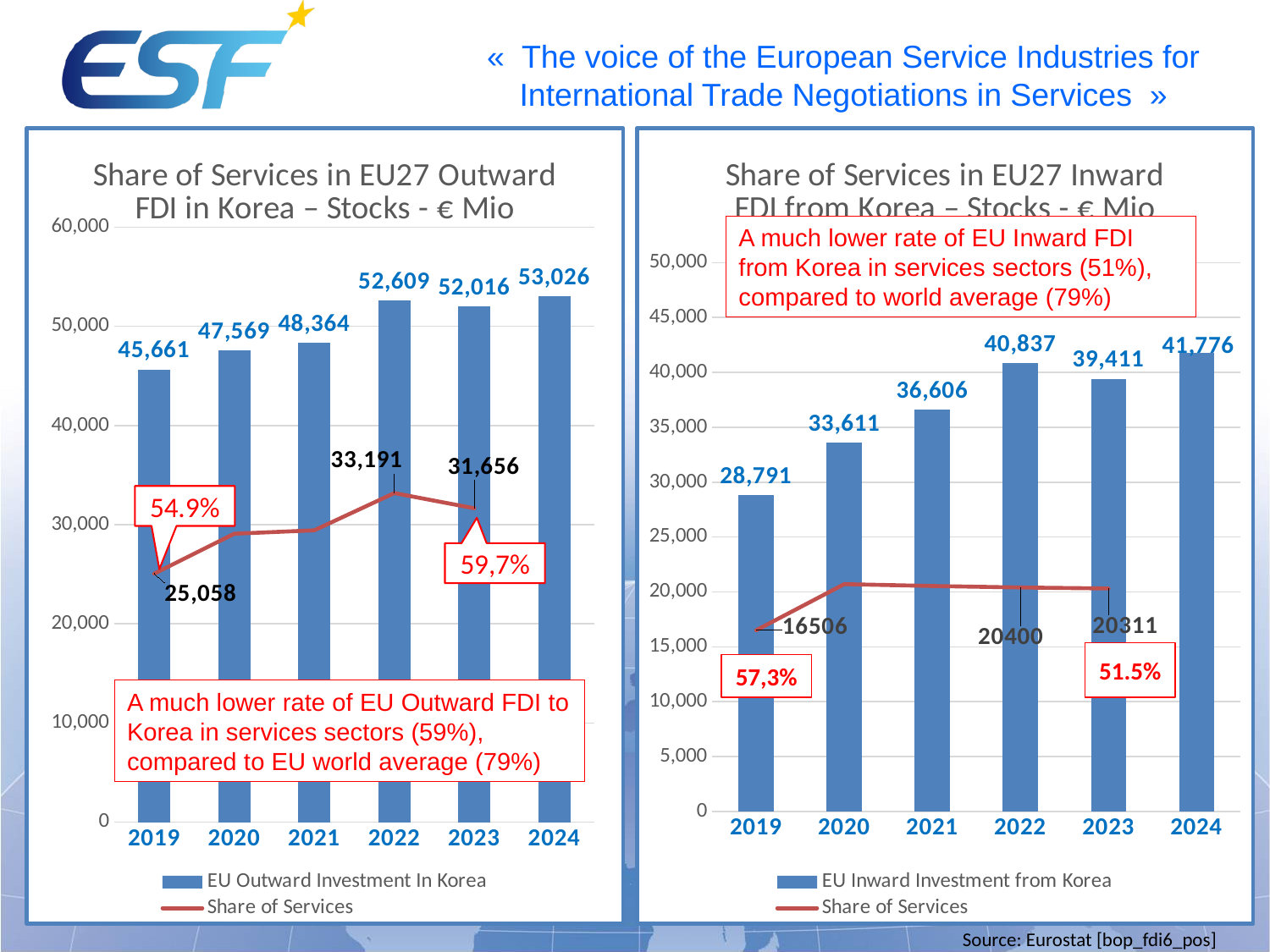
In the right chart (Share of Services in EU27 Inward FDI from Korea), how many years are shown on the x axis? 6 In the right chart (Share of Services in EU27 Inward FDI from Korea), what is the Share of Services value labelled for 2022? 20400 In the left chart (Share of Services in EU27 Outward FDI in Korea), what is the difference between the EU Outward Investment In Korea values for 2024 and 2019? 7,365 What type of chart is used for the EU Inward Investment from Korea series in the right chart? bar chart In the left chart (Share of Services in EU27 Outward FDI in Korea), what is the Share of Services value labelled for 2019? 25,058 In the left chart (Share of Services in EU27 Outward FDI in Korea), how many series does the legend list? 2 In the right chart (Share of Services in EU27 Inward FDI from Korea), what is the value of EU Inward Investment from Korea for 2021? 36,606 In the left chart (Share of Services in EU27 Outward FDI in Korea), what is the value of EU Outward Investment In Korea for 2022? 52,609 In the right chart (Share of Services in EU27 Inward FDI from Korea), which year has the highest EU Inward Investment from Korea? 2024 In the left chart (Share of Services in EU27 Outward FDI in Korea), which year has the highest EU Outward Investment In Korea? 2024 In the right chart (Share of Services in EU27 Inward FDI from Korea), is the EU Inward Investment from Korea value for 2022 larger or smaller than the value for 2023? larger In the left chart (Share of Services in EU27 Outward FDI in Korea), which year has the lowest EU Outward Investment In Korea? 2019